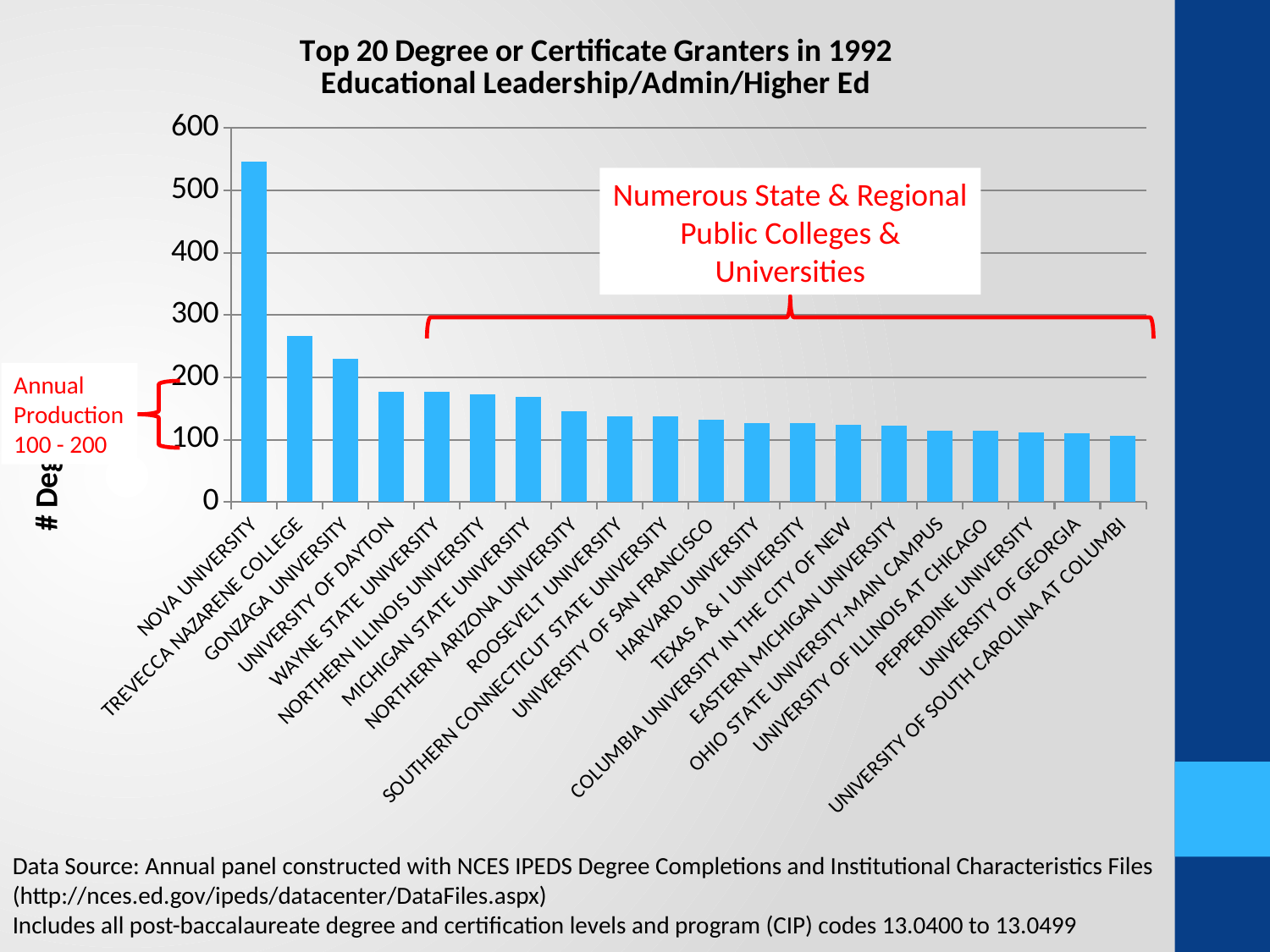
How many institutions are plotted on the chart? 20 Is the value for Harvard University greater or less than 100? greater Do the bar values rise or fall moving from left to right along the x axis? fall What is the title of the chart? Top 20 Degree or Certificate Granters in 1992 Educational Leadership/Admin/Higher Ed Is the value for University of Dayton greater or less than 200? less Is the value for Trevecca Nazarene College greater or less than 300? less Which institution has the highest number of degrees on the chart? Nova University What kind of chart is shown on the slide? bar chart Which has a larger value, Gonzaga University or Harvard University? Gonzaga University Which has a larger value, Nova University or Trevecca Nazarene College? Nova University